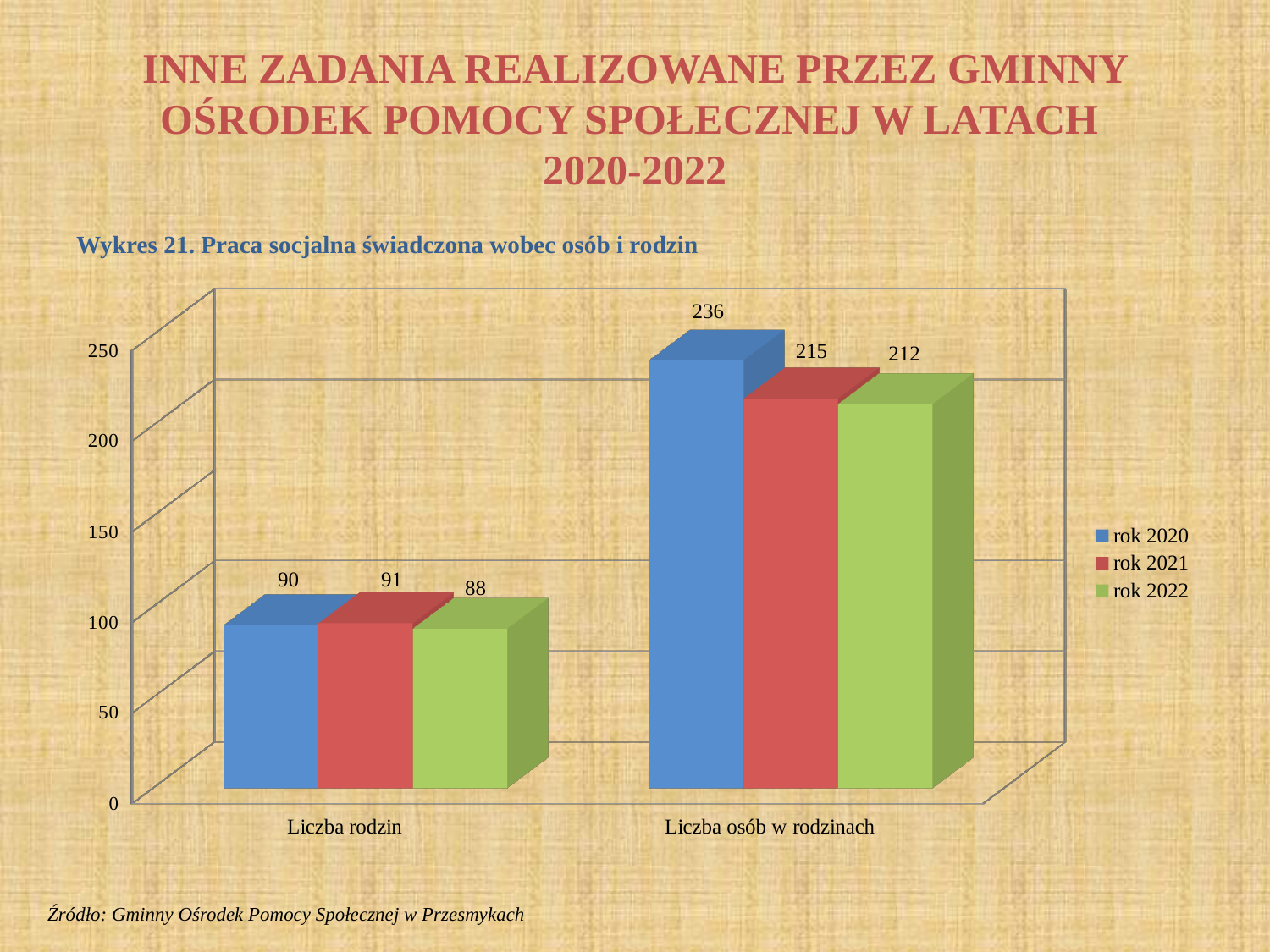
What is the value for 'Liczba rodzin' in the 'rok 2020' series? 90 What kind of chart is shown on the slide? bar chart Which series has the lowest value for 'Liczba rodzin'? rok 2022 What is the value for 'Liczba osób w rodzinach' in the 'rok 2022' series? 212 How many series does the legend list? 3 What is the title of the chart? Wykres 21. Praca socjalna świadczona wobec osób i rodzin What is the difference between the 'rok 2020' and 'rok 2022' values for 'Liczba osób w rodzinach'? 24 Which is larger: the 'rok 2021' value for 'Liczba rodzin' or the 'rok 2020' value for 'Liczba rodzin'? rok 2021 Which series has the highest value for 'Liczba osób w rodzinach'? rok 2020 What is the value for 'Liczba osób w rodzinach' in the 'rok 2021' series? 215 What is the difference between the 'rok 2021' and 'rok 2022' values for 'Liczba rodzin'? 3 How many categories are shown on the x axis? 2